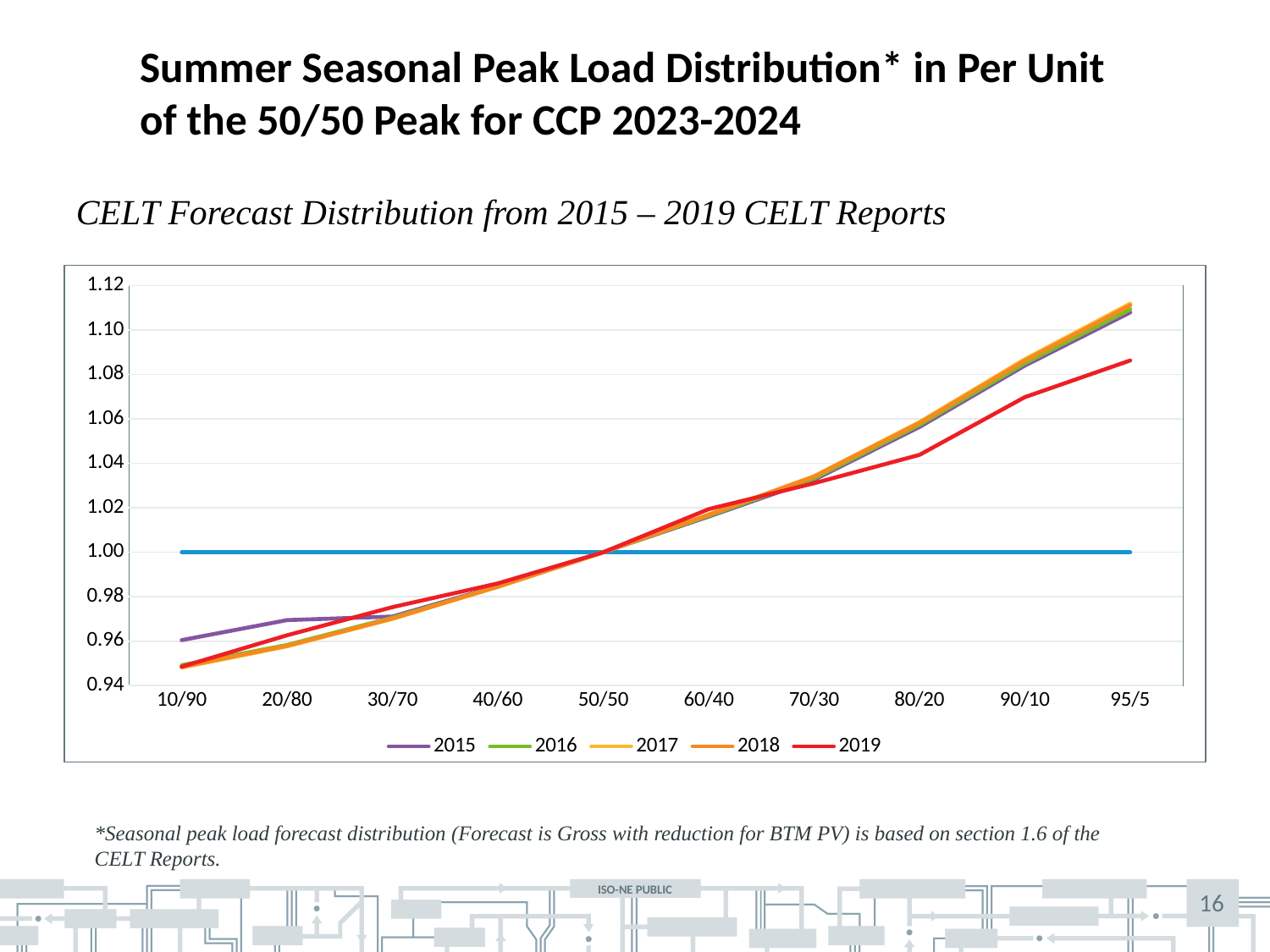
Which series are listed in the legend? 2015, 2016, 2017, 2018, 2019 Do the values for the 2019 series rise or fall from 10/90 to 95/5? rise At 95/5, which series has the lowest value? 2019 Is the value for the 2019 series at 95/5 greater or less than 1.06? greater Is the value for the 2017 series at 95/5 greater or less than 1.10? greater Is the value for the 2015 series at 10/90 greater or less than 0.98? less How many series does the legend list? 5 What kind of chart is shown on the slide? line chart At 10/90, which is larger: the value for 2015 or the value for 2019? 2015 What is the value for the 2019 series at 50/50? 1.00 How many categories are shown on the x axis? 10 What is the title of the slide containing the chart? Summer Seasonal Peak Load Distribution* in Per Unit of the 50/50 Peak for CCP 2023-2024